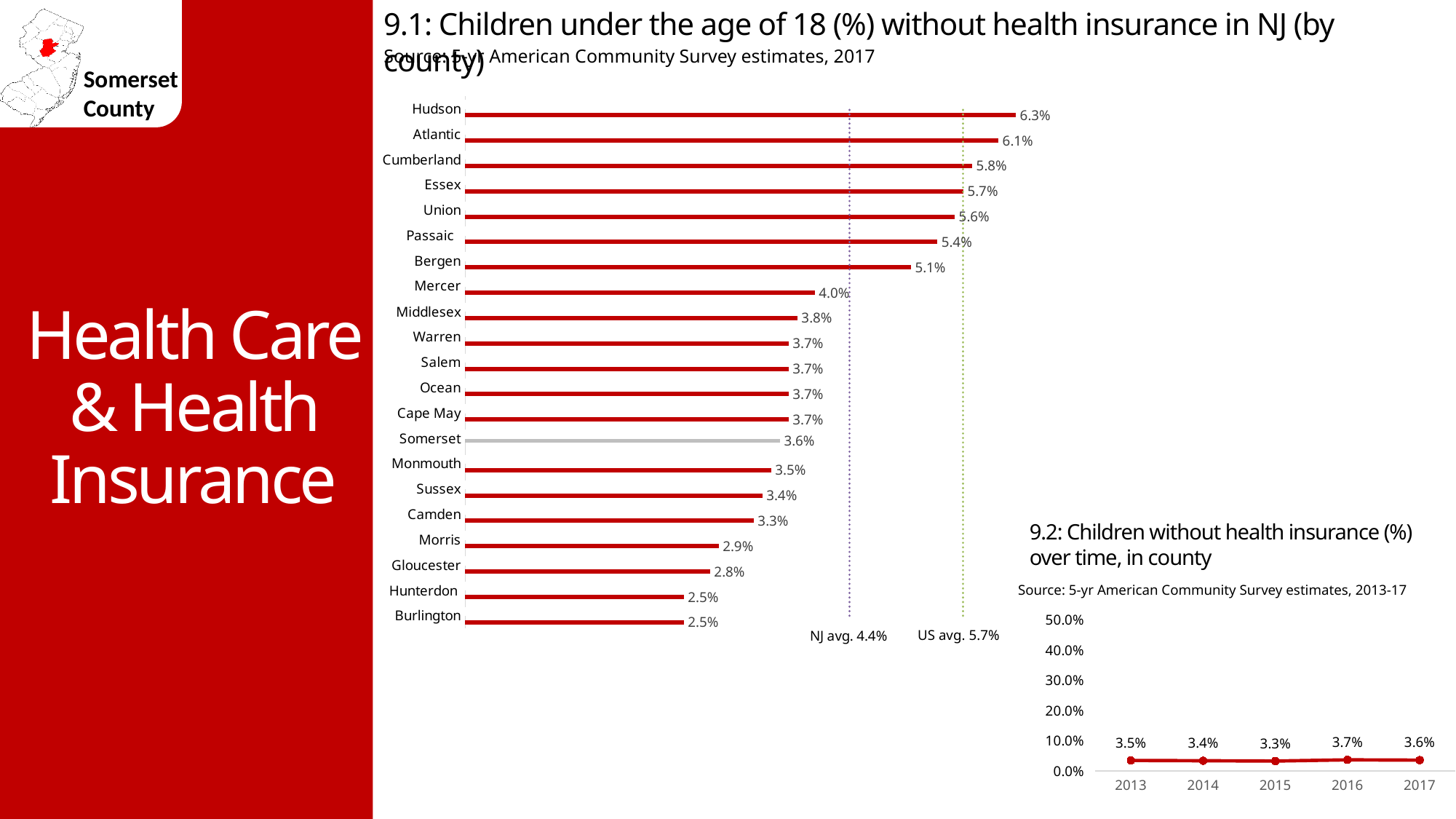
In chart 9.1, which county has the highest value? Hudson In chart 9.1, what is the value for Somerset? 3.6% In chart 9.2, how many years are plotted? 5 In chart 9.1, how many counties are shown? 21 In chart 9.2, which year has the lowest value? 2015 In chart 9.1, which is larger, the value for Mercer or the value for Middlesex? Mercer In chart 9.2, what is the value for 2016? 3.7% In chart 9.1, what is the value for Bergen? 5.1% In chart 9.1, what is the difference between Hudson and Somerset? 2.7% In chart 9.1, what is the NJ average shown by the dotted line? 4.4% What kind of chart is chart 9.1? bar chart What kind of chart is chart 9.2? line chart